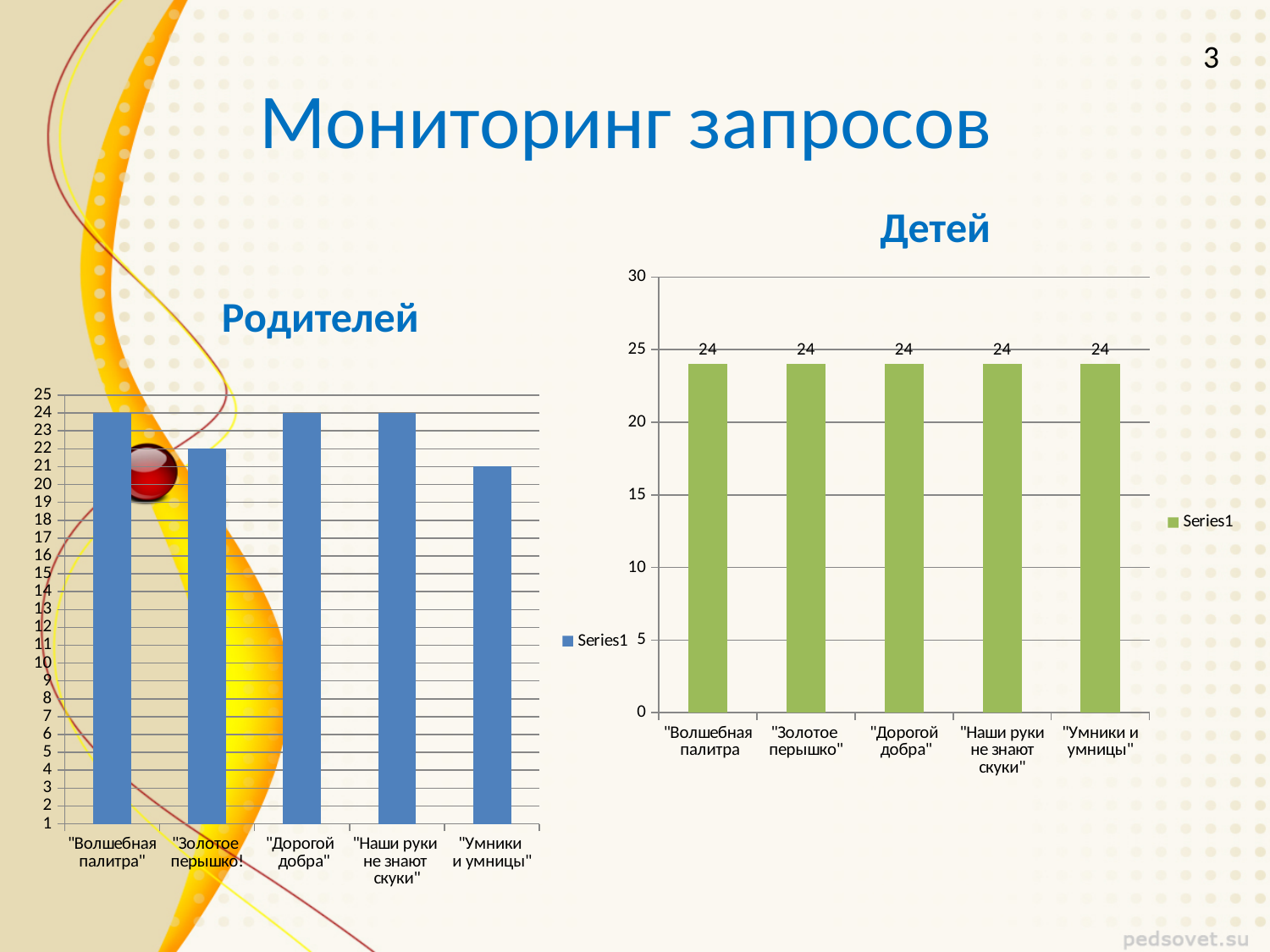
In the "Родителей" chart, is the value for "Умники и умницы" greater or less than 20? greater In the "Родителей" chart, which category has the lowest value? "Умники и умницы" What kind of chart is the "Детей" chart on the right? bar chart How many categories are shown in the "Родителей" chart? 5 In the "Родителей" chart, what is the difference between the values for "Волшебная палитра" and "Умники и умницы"? 3 In the "Детей" chart, do the values rise, fall or stay the same across the categories? stay the same In the "Родителей" chart, what is the value for "Золотое перышко"? 22 In the "Детей" chart, what is the value for "Дорогой добра"? 24 What colour are the bars in the "Детей" chart? green How many categories are shown in the "Детей" chart? 5 In the "Родителей" chart, which is larger: "Волшебная палитра" or "Умники и умницы"? "Волшебная палитра" How many series does the legend of the "Детей" chart list? 1